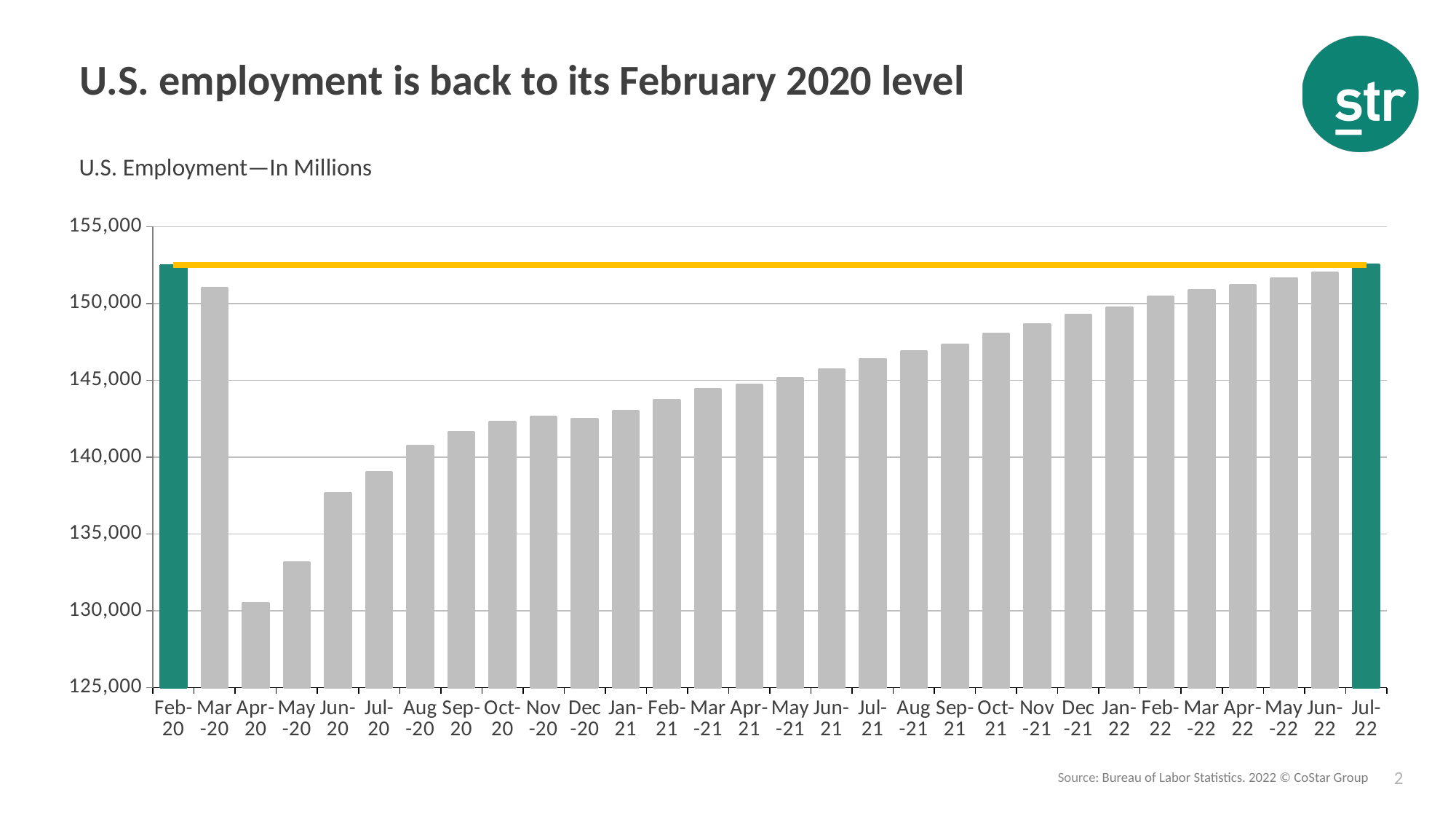
How many months (bars) are plotted in the chart? 30 Is the value for Jan-21 greater or less than 140,000? greater Which is larger, the value for Mar-20 or the value for Apr-20? Mar-20 Is the value for Apr-20 greater or less than 135,000? less Which is larger, the value for Jul-20 or the value for Aug-20? Aug-20 What kind of chart is shown on the slide? Bar chart What is the title of the chart? U.S. Employment—In Millions Is the value for Jun-20 greater or less than 140,000? less From Apr-20 to Jul-22, do the values generally rise or fall? Rise Which month has the lowest employment value in the chart? Apr-20